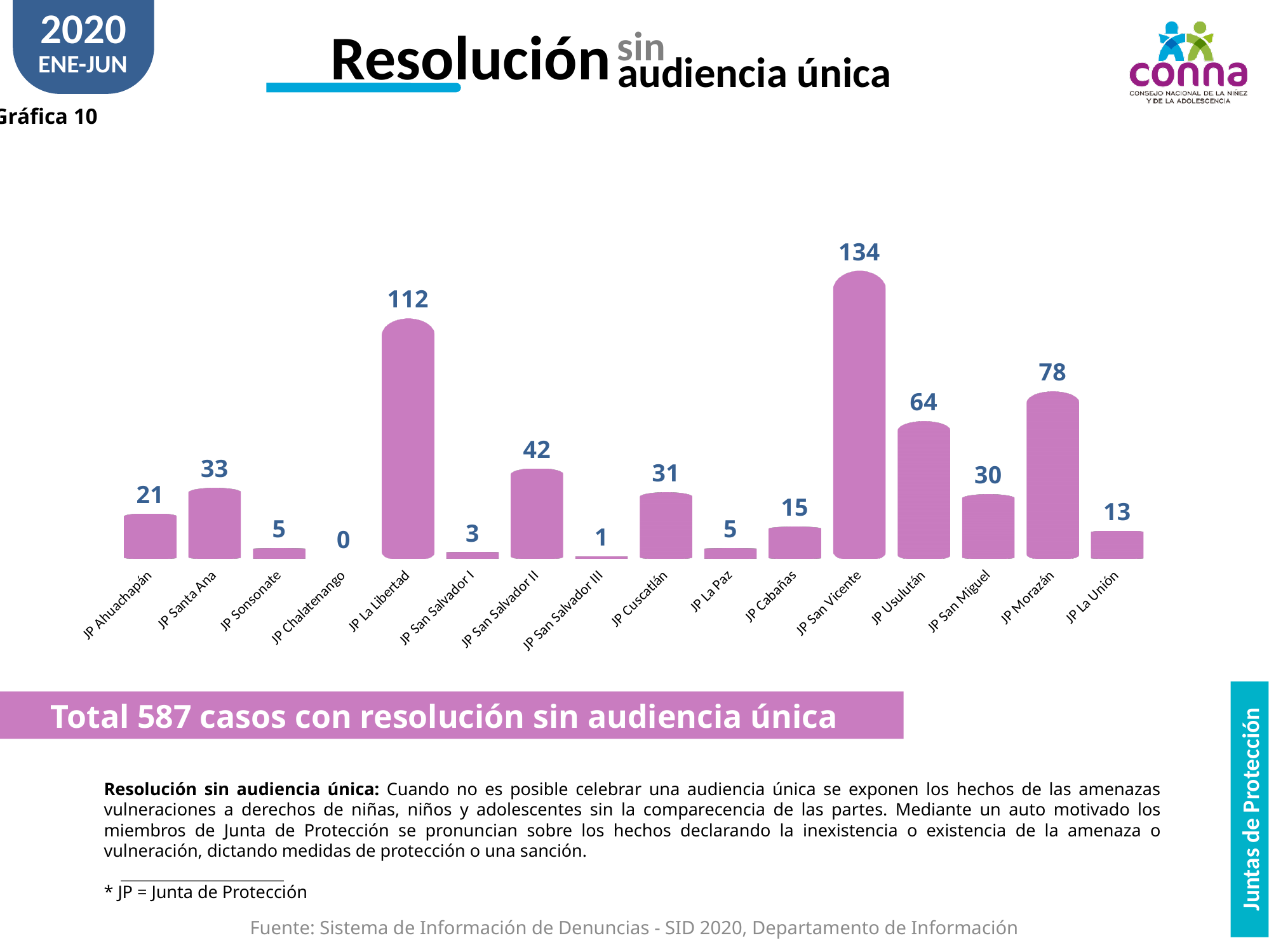
What is the value for JP La Libertad? 112 How many categories are shown on the x axis? 16 Which is larger, the value for JP Santa Ana or the value for JP Cuscatlán? JP Santa Ana What is the difference between the values for JP San Vicente and JP La Libertad? 22 Which is larger, the value for JP San Salvador II or the value for JP San Miguel? JP San Salvador II Which category has the highest value? JP San Vicente What kind of chart is shown on the slide? Bar chart What is the value for JP Usulután? 64 What total number of cases is stated in the banner below the chart? 587 What is the difference between the values for JP Morazán and JP Usulután? 14 What is the value for JP Cabañas? 15 Which category has the lowest value? JP Chalatenango